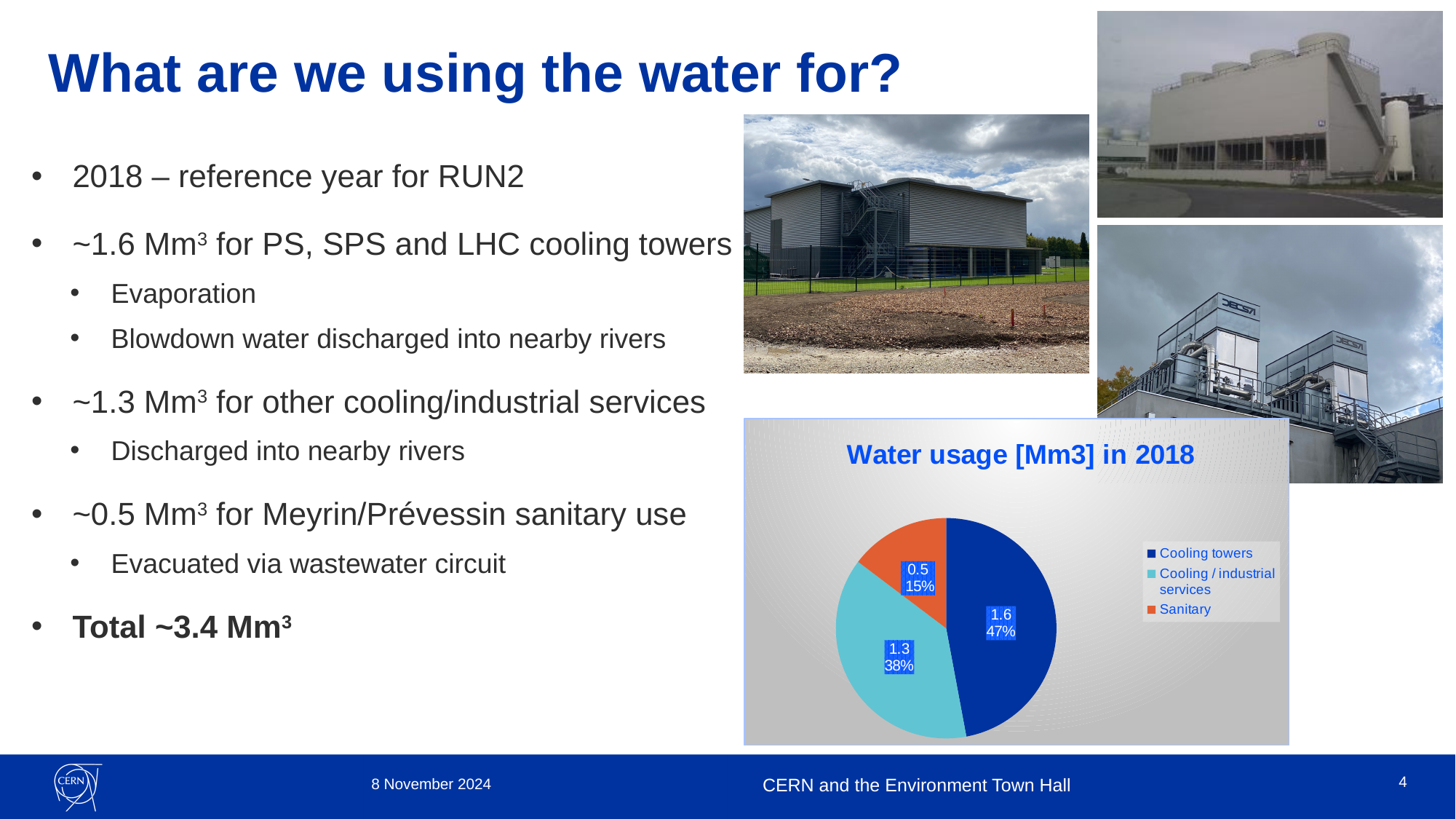
Which category has the smallest slice of the pie? Sanitary How many categories does the legend of the pie chart list? 3 What is the value for Cooling / industrial services in the pie chart? 1.3 What share of the pie does Cooling towers represent? 47% What kind of chart is shown on the slide? pie chart What is the title of the chart? Water usage [Mm3] in 2018 What is the difference between the Cooling towers value and the Sanitary value? 1.1 What is the value for Cooling towers in the pie chart? 1.6 Which is larger, Cooling / industrial services or Sanitary? Cooling / industrial services What is the value for Sanitary in the pie chart? 0.5 What share of the pie does Sanitary represent? 15% Which category has the largest slice of the pie? Cooling towers